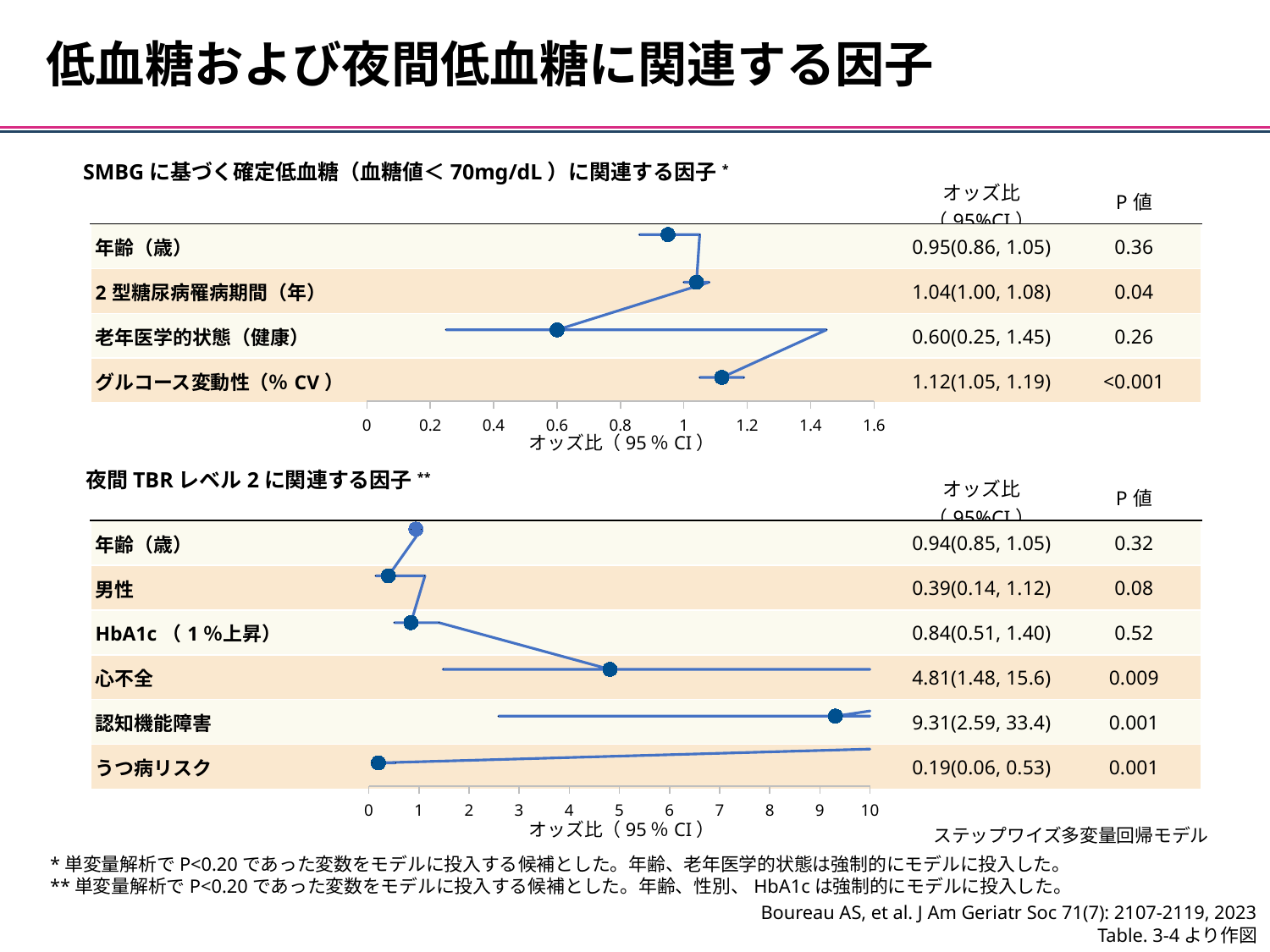
In the bottom chart (夜間TBRレベル2に関連する因子), which factor has the lowest odds ratio? うつ病リスク In the top chart (SMBGに基づく確定低血糖に関連する因子), which factor has the lowest odds ratio? 老年医学的状態（健康） In the bottom chart (夜間TBRレベル2に関連する因子), which factor has the highest odds ratio? 認知機能障害 In the bottom chart (夜間TBRレベル2に関連する因子), which has the larger odds ratio, 男性 or HbA1c（1%上昇）? HbA1c（1%上昇） In the bottom chart (夜間TBRレベル2に関連する因子), what is the difference between the odds ratios of 認知機能障害 and 心不全? 4.50 In the bottom chart (夜間TBRレベル2に関連する因子), what is the P value for 心不全? 0.009 What is the x-axis label of the bottom chart (夜間TBRレベル2に関連する因子)? オッズ比（95% CI） In the top chart (SMBGに基づく確定低血糖に関連する因子), what is the P value for 2型糖尿病罹病期間（年）? 0.04 In the bottom chart (夜間TBRレベル2に関連する因子), what is the odds ratio (95% CI) for 認知機能障害? 9.31(2.59, 33.4) In the bottom chart (夜間TBRレベル2に関連する因子), how many factors are plotted? 6 In the top chart (SMBGに基づく確定低血糖に関連する因子), what is the odds ratio (95% CI) for グルコース変動性（%CV）? 1.12(1.05, 1.19) In the top chart (SMBGに基づく確定低血糖に関連する因子), how many factors are plotted? 4